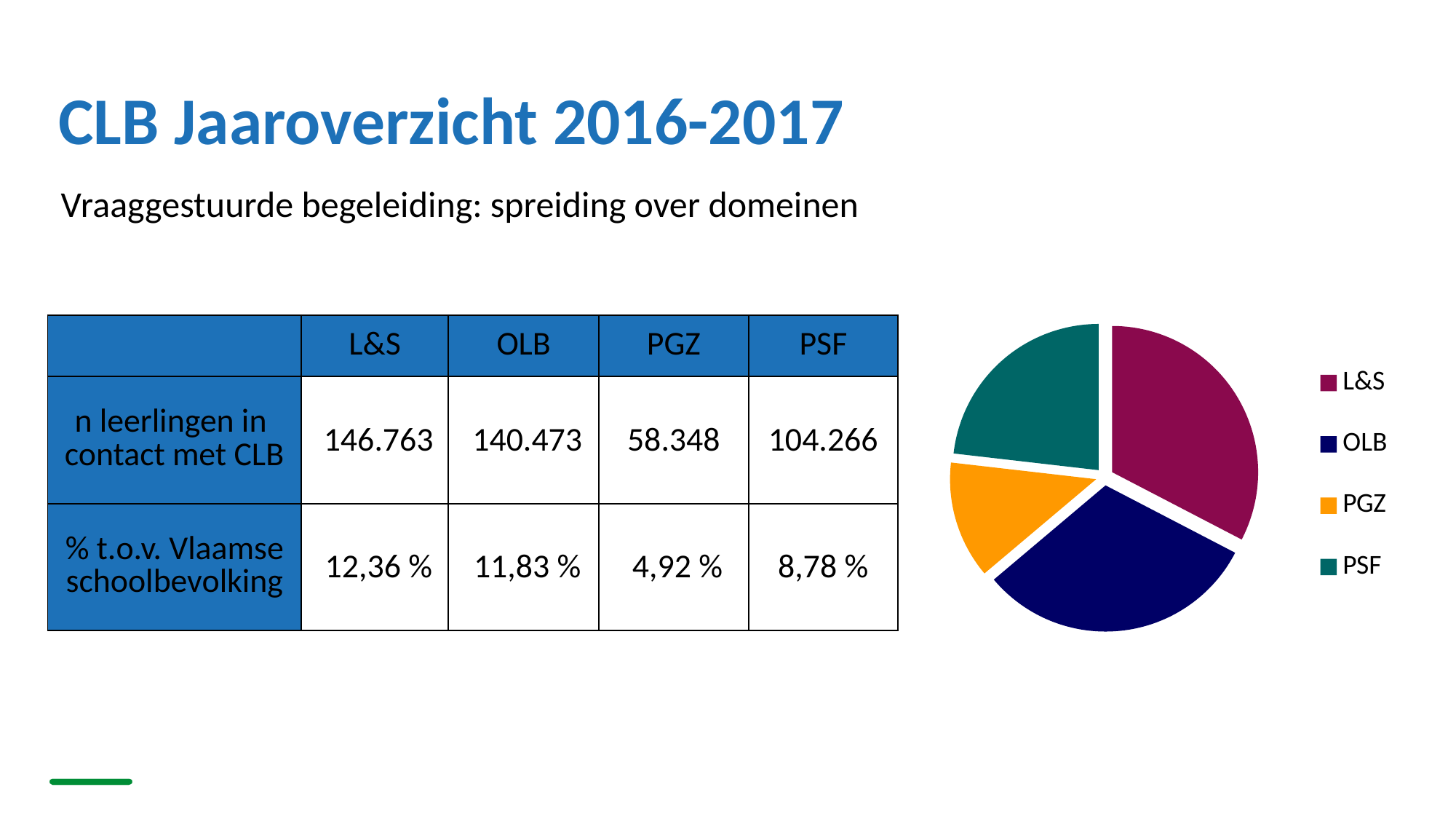
Which category has the smallest slice in the pie chart? PGZ Does the PGZ slice take up more or less than a quarter of the pie chart? less What colour is the PGZ slice in the pie chart? orange Which categories are listed in the pie chart's legend? L&S, OLB, PGZ, PSF In the pie chart, which slice is larger: L&S or PGZ? L&S What type of chart is shown on the right of the slide? pie chart In the pie chart, which slice is larger: OLB or PSF? OLB In the pie chart, which slice is larger: PGZ or PSF? PSF How many entries does the pie chart's legend list? 4 How many slices does the pie chart have? 4